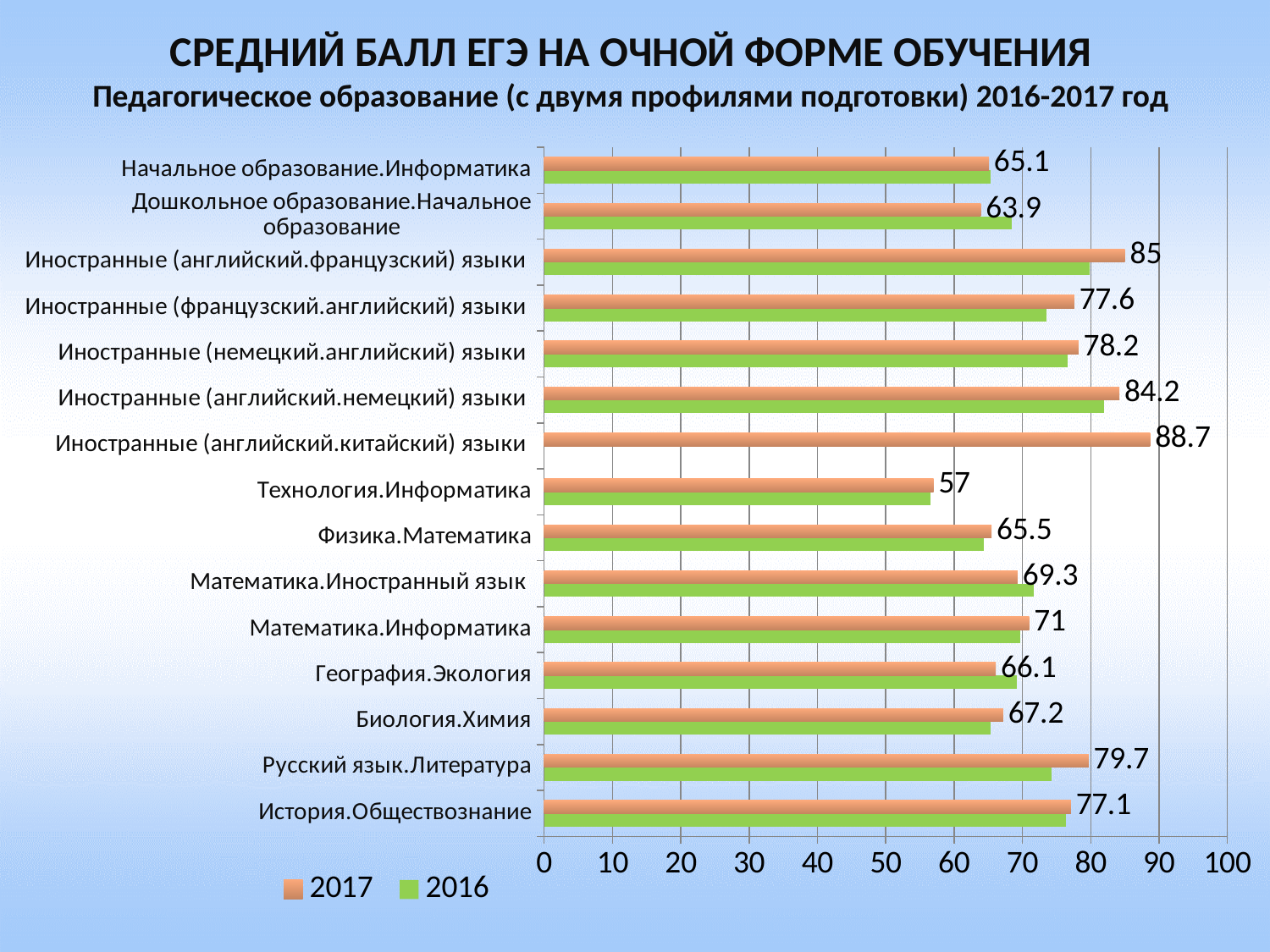
What is the 2017 value for Русский язык.Литература? 79.7 What is the 2017 value for Иностранные (английский.китайский) языки? 88.7 Which has the larger 2017 value: Математика.Информатика or Биология.Химия? Математика.Информатика What is the 2017 value for Дошкольное образование.Начальное образование? 63.9 How many categories are shown on the chart? 15 What is the difference between the 2017 values for Иностранные (английский.французский) языки and История.Обществознание? 7.9 What is the 2017 value for Технология.Информатика? 57 How many series does the legend list? 2 Which category has the lowest 2017 value? Технология.Информатика What kind of chart is shown on the slide? bar chart Which category has the highest 2017 value? Иностранные (английский.китайский) языки Is the 2016 value for Русский язык.Литература greater or less than 70? greater